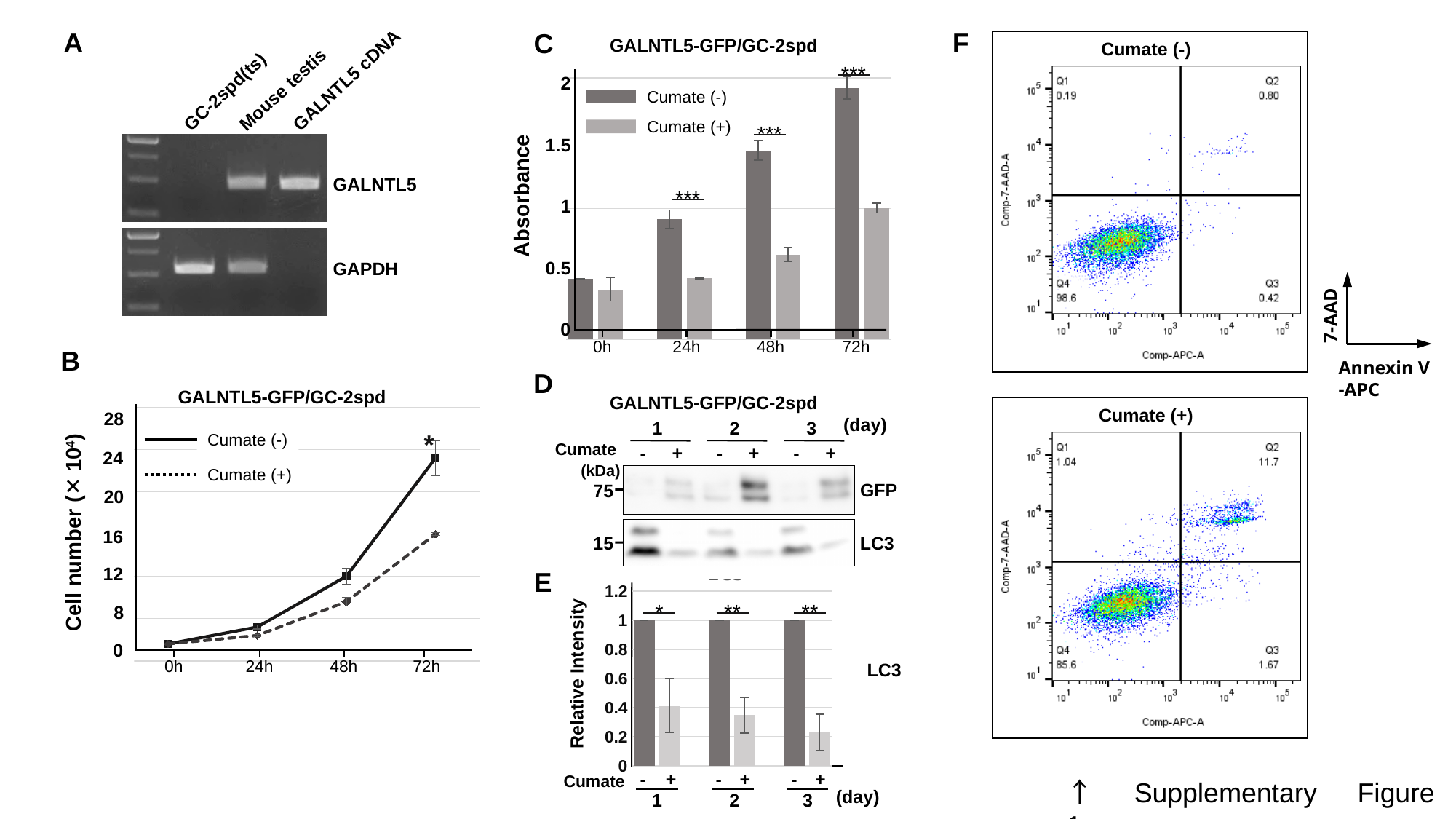
In chart C (absorbance), is the value for Cumate (-) at 72h greater or less than 1.5? greater In chart B (Cell number), is the value for Cumate (-) at 72h greater or less than 20? greater In chart C (absorbance), does the Cumate (-) series rise or fall from 0h to 72h? rise In chart B (Cell number), how many time points are plotted on the x axis? 4 In chart C (absorbance), which bar is the highest? Cumate (-) at 72h In chart B (Cell number), at 72h, which series has the larger value, Cumate (-) or Cumate (+)? Cumate (-) In chart C (GALNTL5-GFP/GC-2spd absorbance), how many series does the legend list? 2 In chart E (Relative Intensity of LC3), is the Cumate (+) value on day 3 greater or less than 0.4? less What kind of chart is chart B (Cell number)? line chart In panel F, what is the difference between the Q2 percentages of the Cumate (+) plot and the Cumate (-) plot? 10.9 In panel F, what percentage is shown in quadrant Q2 of the Cumate (+) plot? 11.7